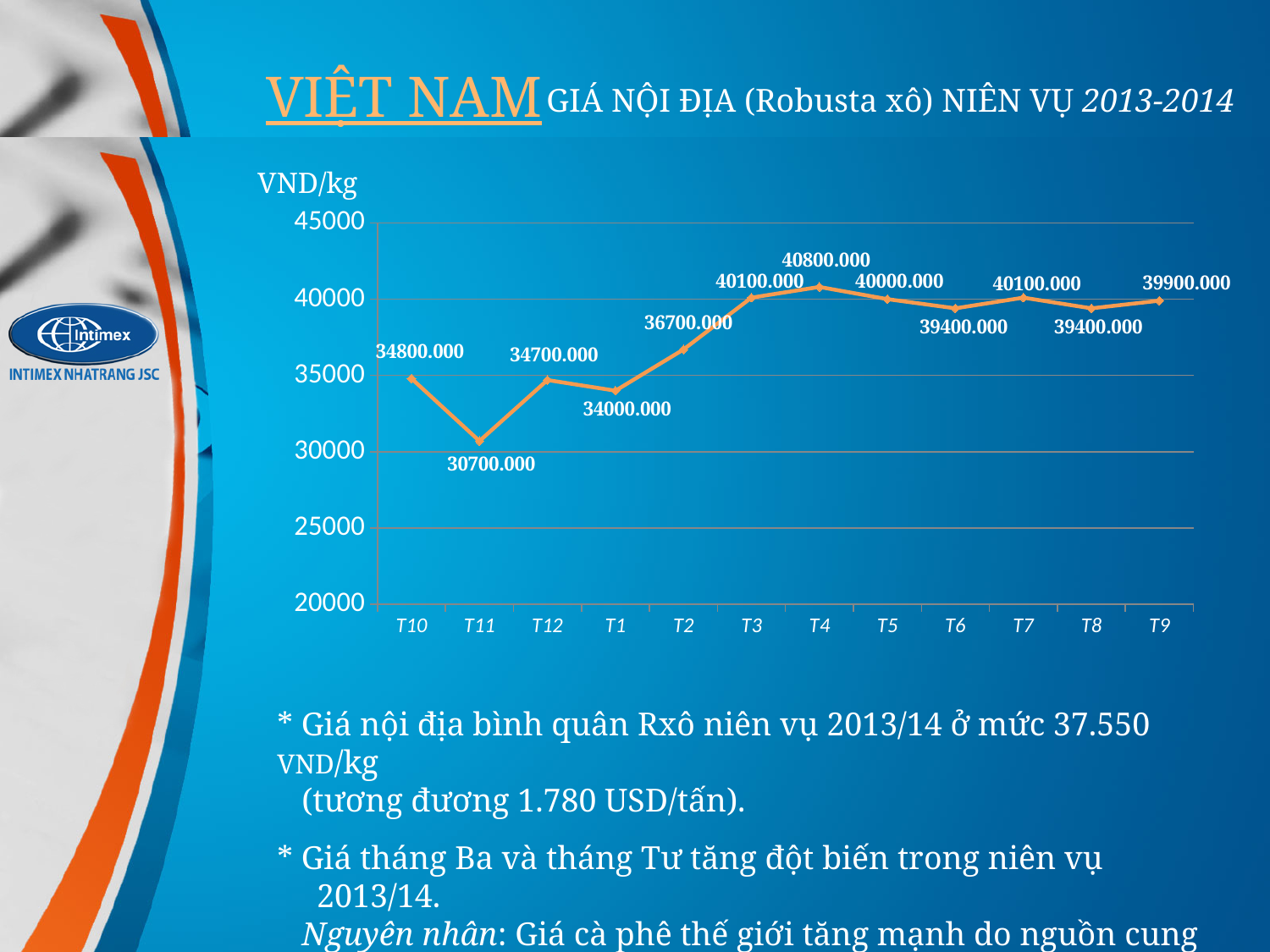
What is the value for T9? 39900.000 Is the value for T1 greater or less than 35000? less What is the value for T2? 36700.000 What unit is shown above the y axis of the chart? VND/kg Which month has the lowest value? T11 Which is larger, the value for T10 or the value for T12? T10 What kind of chart is shown? line chart What is the difference between the values for T4 and T11? 10100.000 How many months are plotted on the x axis? 12 What is the value for T11? 30700.000 Which month has the highest value? T4 What is the value for T4? 40800.000